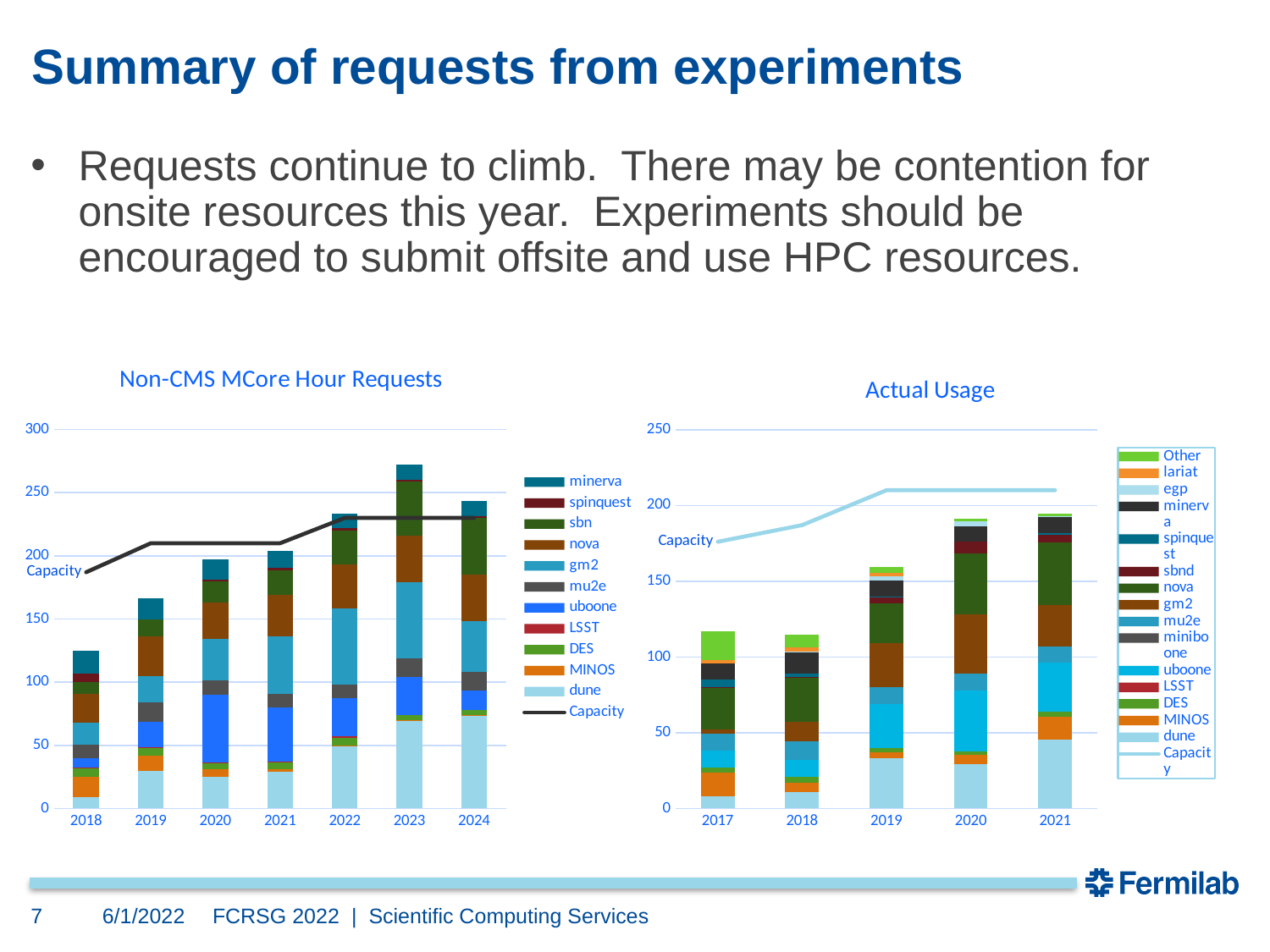
In the 'Actual Usage' chart, what does the light blue line represent according to the legend? Capacity In the 'Non-CMS MCore Hour Requests' chart, which year has the shortest stacked bar? 2018 What type of chart is the 'Non-CMS MCore Hour Requests' chart? Stacked bar chart with a line In the 'Non-CMS MCore Hour Requests' chart, how many entries does the legend list? 12 In the 'Non-CMS MCore Hour Requests' chart, which year has the tallest stacked bar? 2023 In the 'Actual Usage' chart, how many years are shown on the x axis? 5 In the 'Actual Usage' chart, which is larger, the total bar for 2020 or for 2018? 2020 In the 'Actual Usage' chart, is the total bar for 2019 greater or less than 150? greater In the 'Non-CMS MCore Hour Requests' chart, how many years are shown on the x axis? 7 In the 'Non-CMS MCore Hour Requests' chart, is the total bar for 2023 greater or less than 250? greater In the 'Non-CMS MCore Hour Requests' chart, which is larger, the total bar for 2022 or for 2021? 2022 In the 'Non-CMS MCore Hour Requests' chart, is the total bar for 2018 greater or less than 150? less